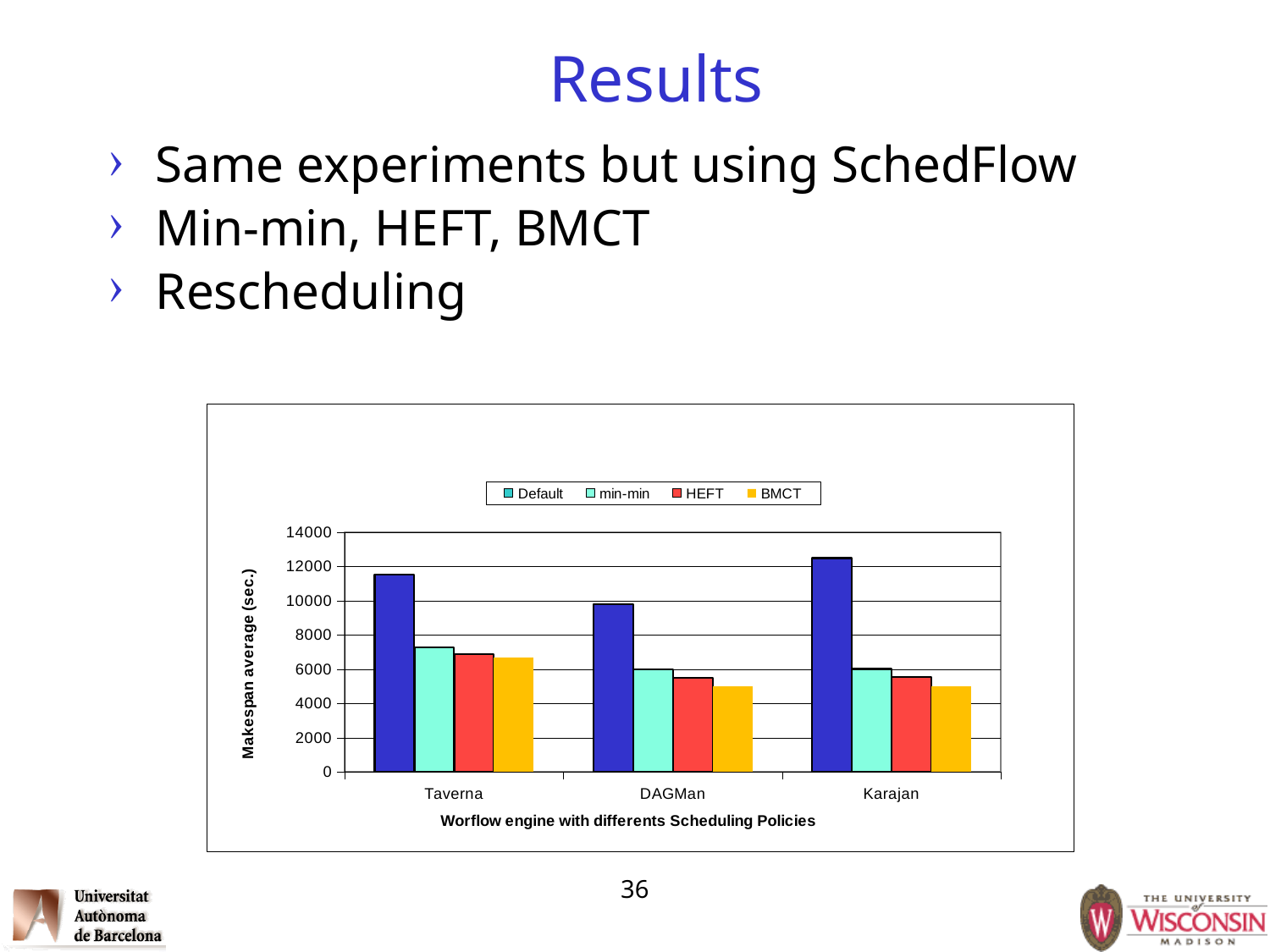
How many series does the legend list? 4 Which workflow engine has the highest Default makespan average? Karajan Is the min-min makespan average for Taverna greater or less than 6000? greater For Karajan, which is larger, the Default bar or the BMCT bar? Default What is the label of the y axis? Makespan average (sec.) How many workflow engines (categories) are shown on the x axis? 3 Is the Default makespan average for Karajan greater or less than 10000? greater Which is larger, the Default makespan average for Taverna or for DAGMan? Taverna Is the BMCT makespan average for DAGMan greater or less than 6000? less What kind of chart is shown on the slide? bar chart Which workflow engine has the lowest Default makespan average? DAGMan